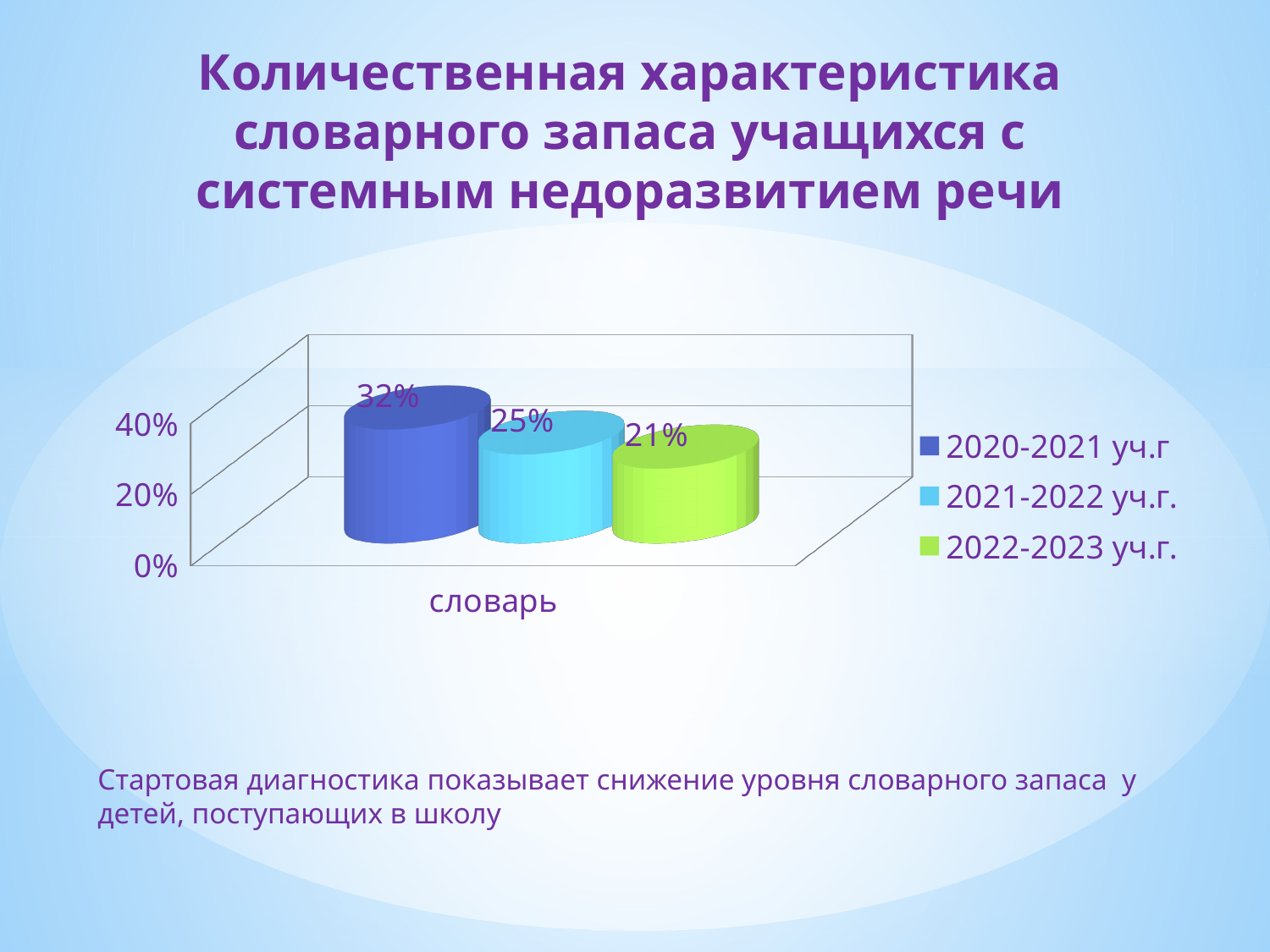
Which series has the lowest value? 2022-2023 уч.г. What is the difference between the values for 2021-2022 уч.г. and 2022-2023 уч.г.? 4% What is the value for 2021-2022 уч.г.? 25% Is the value for 2020-2021 уч.г greater or less than 20%? greater Which series has the highest value? 2020-2021 уч.г How many series does the legend list? 3 What is the value for 2020-2021 уч.г? 32% What is the category label shown on the x axis? словарь What is the difference between the values for 2020-2021 уч.г and 2022-2023 уч.г.? 11% Which is larger, the value for 2020-2021 уч.г or the value for 2021-2022 уч.г.? 2020-2021 уч.г What is the value for 2022-2023 уч.г.? 21% What kind of chart is shown on the slide? bar chart